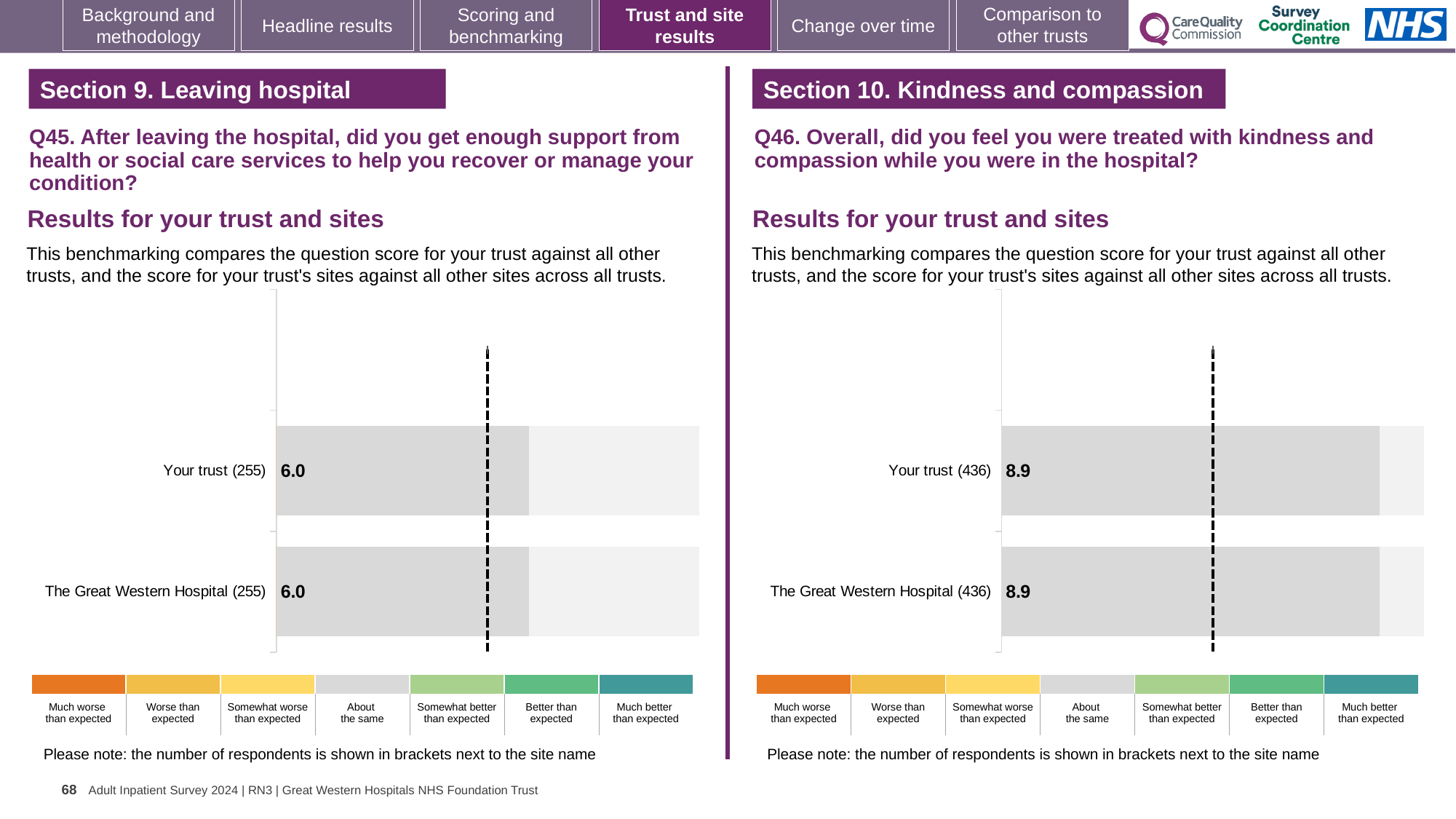
How many bars are plotted in the Q46 chart on the right? 2 In the Q46 chart on the right, what is the score for The Great Western Hospital? 8.9 In the Q45 chart on the left, what is the score for Your trust? 6.0 In the Q45 chart on the left, how many respondents are shown in brackets next to Your trust? 255 In the Q45 chart on the left, what is the score for The Great Western Hospital? 6.0 What kind of chart is used for the Q46 results on the right? Bar chart In the Q45 chart on the left, what is the difference between the score for Your trust and the score for The Great Western Hospital? 0.0 In the Q46 chart on the right, what is the difference between the score for Your trust and the score for The Great Western Hospital? 0.0 How many categories does the colour key below the Q45 chart on the left list? 7 In the Q46 chart on the right, what is the score for Your trust? 8.9 In the Q46 chart on the right, how many respondents are shown in brackets next to The Great Western Hospital? 436 How many bars are plotted in the Q45 chart on the left? 2